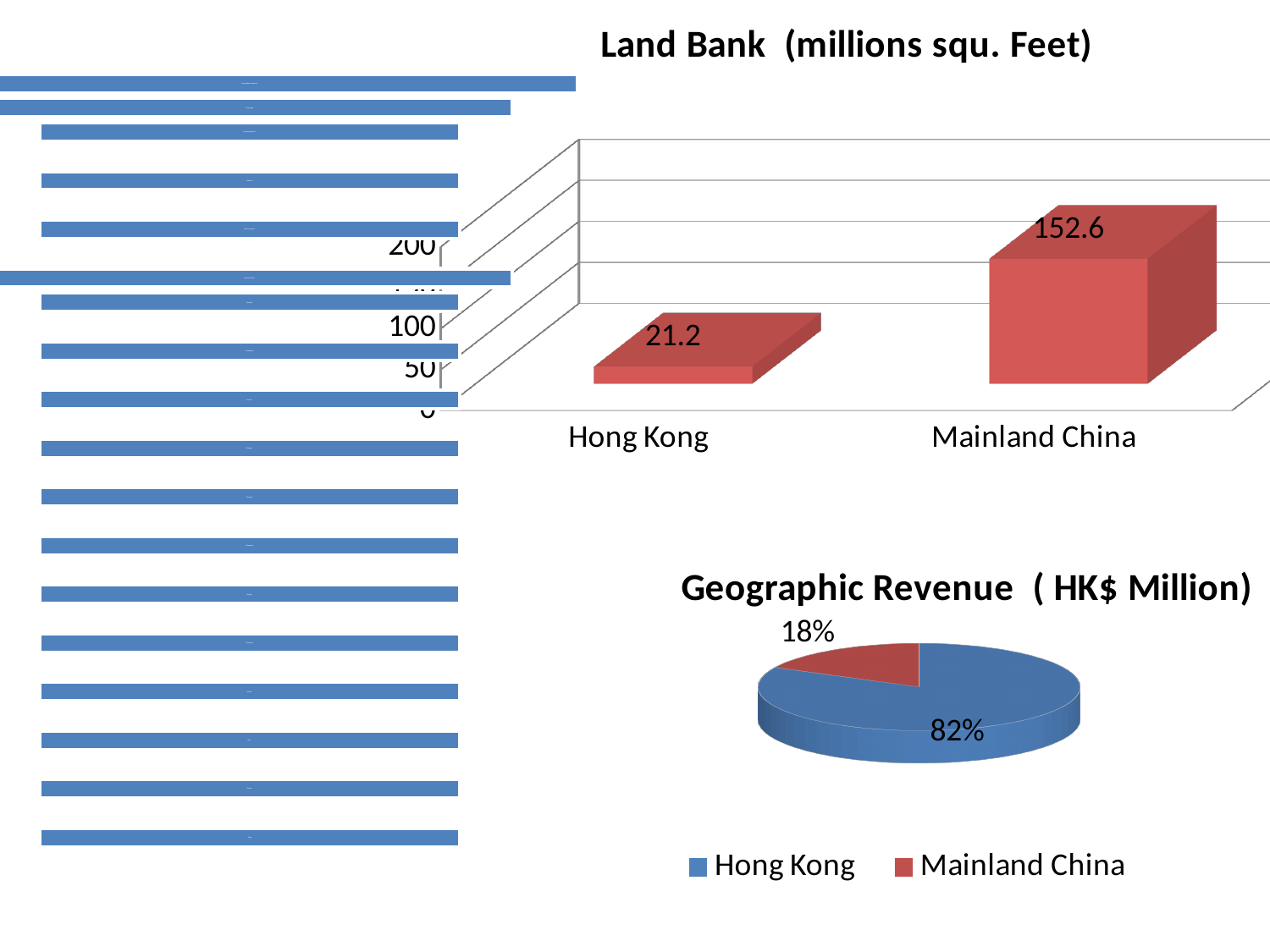
What kind of chart is the Land Bank chart? bar chart What kind of chart is the Geographic Revenue chart? pie chart In the Land Bank chart, which category has the lowest value? Hong Kong In the Land Bank chart, what is the value for Mainland China? 152.6 In the Geographic Revenue chart, how many entries does the legend list? 2 In the Land Bank chart, how many categories are shown on the x axis? 2 In the Land Bank chart, which category has the highest value? Mainland China In the Geographic Revenue chart, what share does Mainland China have? 18% In the Geographic Revenue chart, what share does Hong Kong have? 82% In the Land Bank chart, what is the difference between the Mainland China and Hong Kong values? 131.4 In the Land Bank chart, is the value for Mainland China greater or less than 100? greater In the Land Bank chart, what is the value for Hong Kong? 21.2